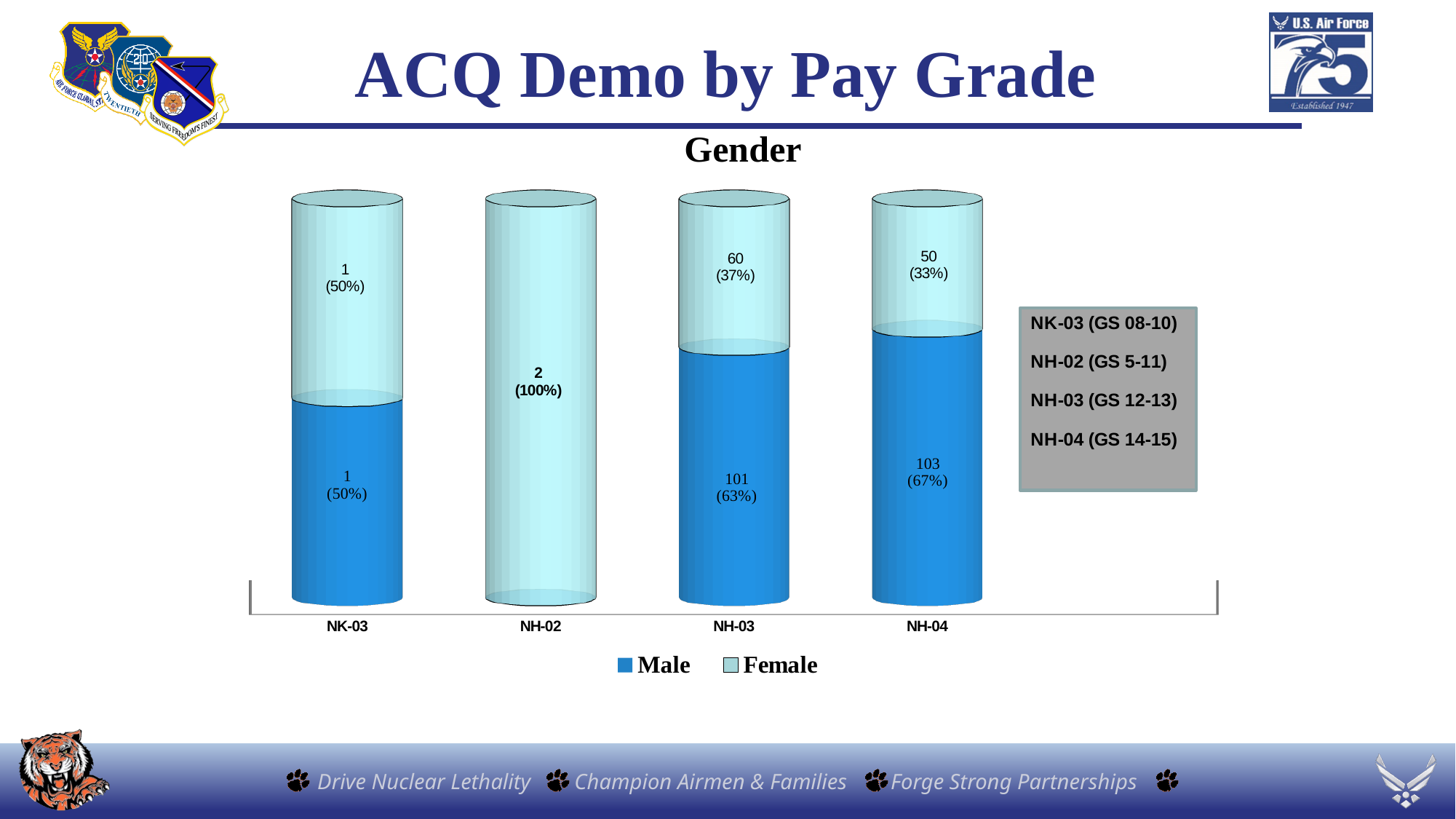
Which pay grade has the lowest Female count? NK-03 Is the Female count larger for NH-03 or NH-04? NH-03 How many series does the legend list? 2 What is the total count (Male plus Female) for NH-04? 153 What is the Male value for NH-03? 101 How many pay grade categories are shown on the x axis? 4 What percentage of NH-02 is Female? 100% What is the Male percentage shown for NH-04? 67% What is the Female value for NH-04? 50 What is the title of the chart? Gender What is the difference between the Male and Female counts for NH-03? 41 Which pay grade has the highest Male count? NH-04